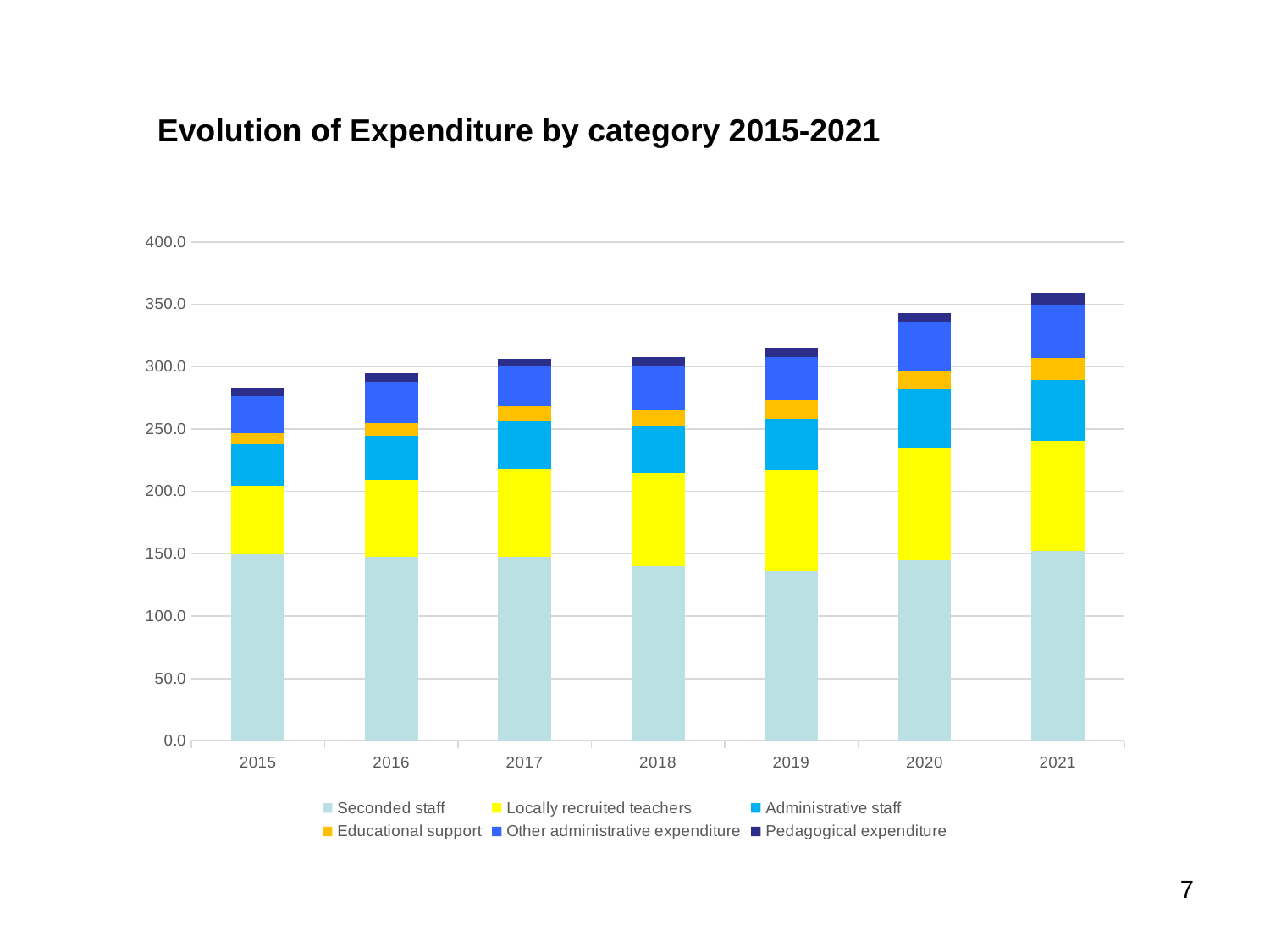
Which year has the tallest stacked bar (highest total expenditure)? 2021 How many years are shown on the x axis of the chart? 7 Is the Seconded staff segment for 2019 greater or less than 150.0? less How many series does the legend list? 6 Do the total stacked bars generally rise or fall from 2015 to 2021? rise Which year has the shortest stacked bar (lowest total expenditure)? 2015 What is the title of the chart? Evolution of Expenditure by category 2015-2021 Is the total stacked bar for 2021 greater or less than 300.0? greater What kind of chart is shown on the slide? Stacked bar chart Is the total stacked bar for 2015 greater or less than 300.0? less Which year has the larger total stacked bar, 2019 or 2020? 2020